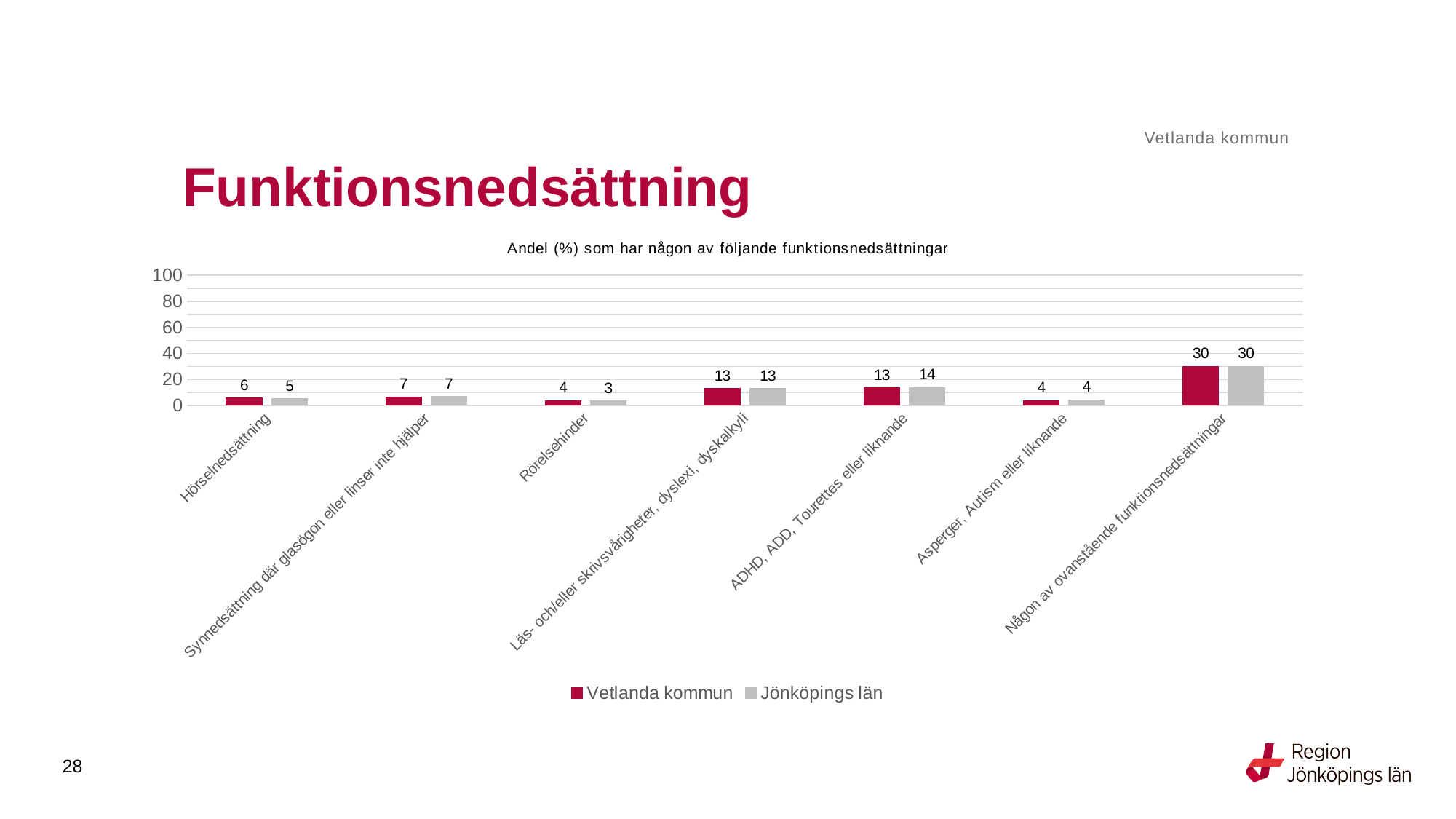
What kind of chart is shown on the slide? Bar chart Which is larger for ADHD, ADD, Tourettes eller liknande: Vetlanda kommun or Jönköpings län? Jönköpings län Which category has the lowest value for Jönköpings län? Rörelsehinder What is the difference between Vetlanda kommun and Jönköpings län for Hörselnedsättning? 1 How many series does the legend list? 2 What is the value for Vetlanda kommun for Rörelsehinder? 4 How many categories are shown on the x axis? 7 What is the value for Jönköpings län for ADHD, ADD, Tourettes eller liknande? 14 What is the value for Vetlanda kommun for Hörselnedsättning? 6 What is the title of the chart? Andel (%) som har någon av följande funktionsnedsättningar Which category has the highest value for Vetlanda kommun? Någon av ovanstående funktionsnedsättningar What is the value for Jönköpings län for Någon av ovanstående funktionsnedsättningar? 30